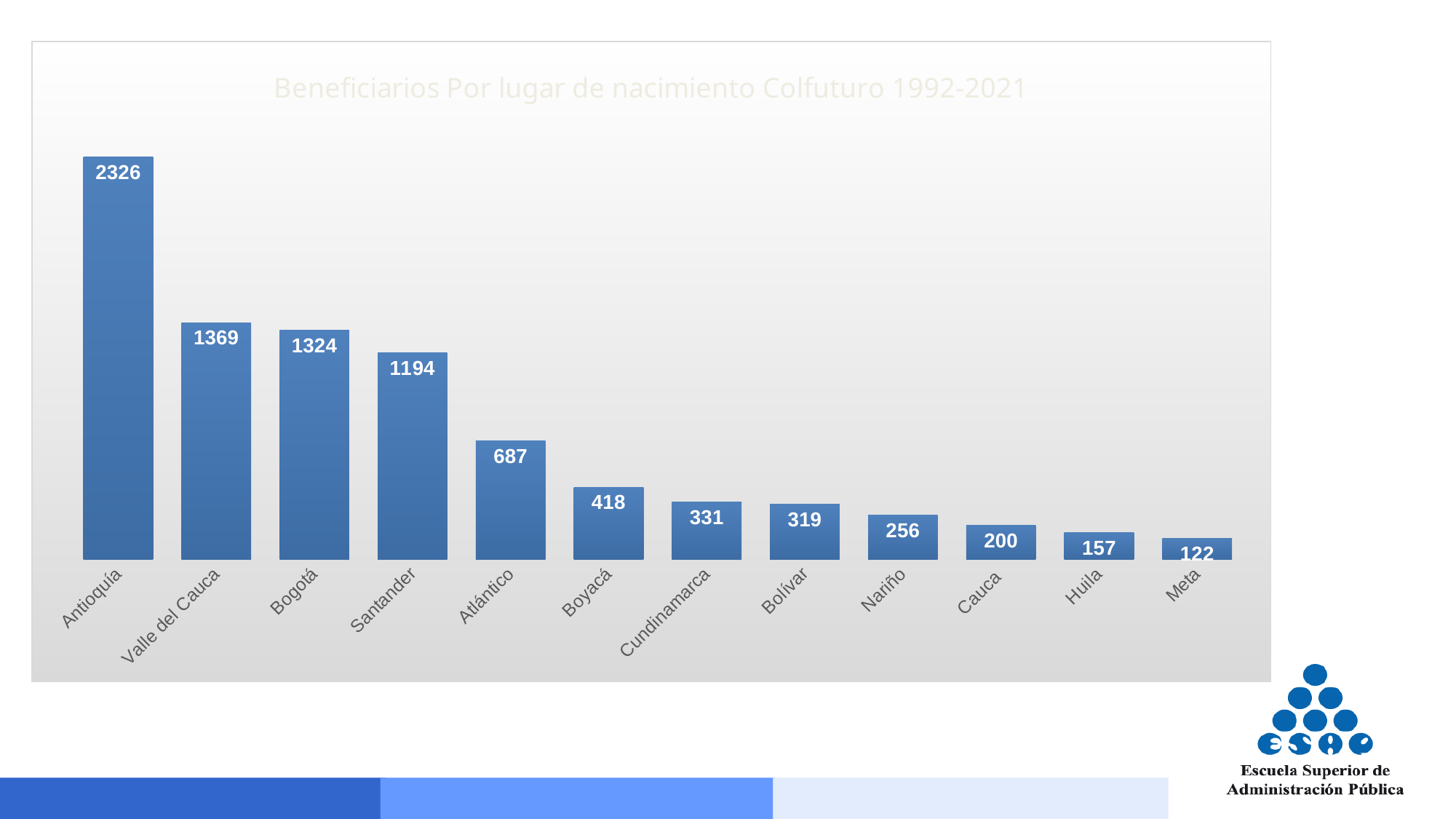
What is the difference between the values for Boyacá and Cauca? 218 What is the value for Cundinamarca? 331 What is the difference between the values for Antioquia and Valle del Cauca? 957 What is the value for Santander? 1194 Which is larger, the value for Valle del Cauca or the value for Bogotá? Valle del Cauca What is the value for Antioquia? 2326 Which is larger, the value for Nariño or the value for Huila? Nariño Do the values rise or fall from left to right along the x axis? Fall What kind of chart is shown on the slide? Bar chart How many categories are shown in the chart? 12 Which category has the lowest value? Meta Which category has the highest value? Antioquia